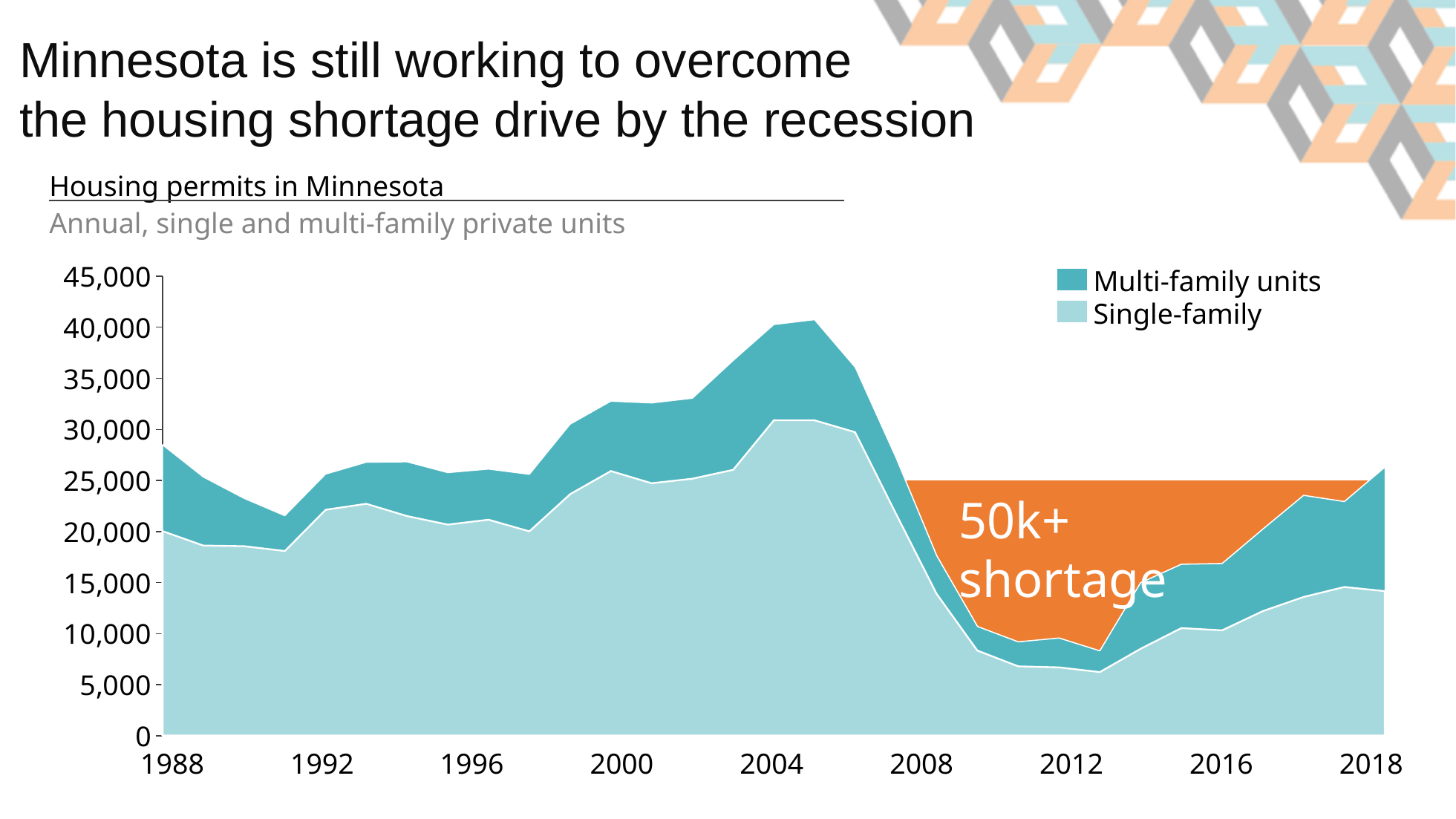
Does the total number of housing permits rise or fall between 2013 and 2018? rise Is the total number of housing permits in 1988 greater or less than 25,000? greater What text is written in the orange shaded region of the chart? 50k+ shortage How many series does the chart's legend list? 2 Which year has the larger total number of housing permits, 2005 or 2012? 2005 Does the total number of housing permits rise or fall between 2005 and 2009? fall Is the total number of housing permits in 2012 greater or less than 15,000? less Is the total number of housing permits in 2000 greater or less than 30,000? greater What kind of chart is shown on the slide? Stacked area chart What is the title of the chart? Housing permits in Minnesota